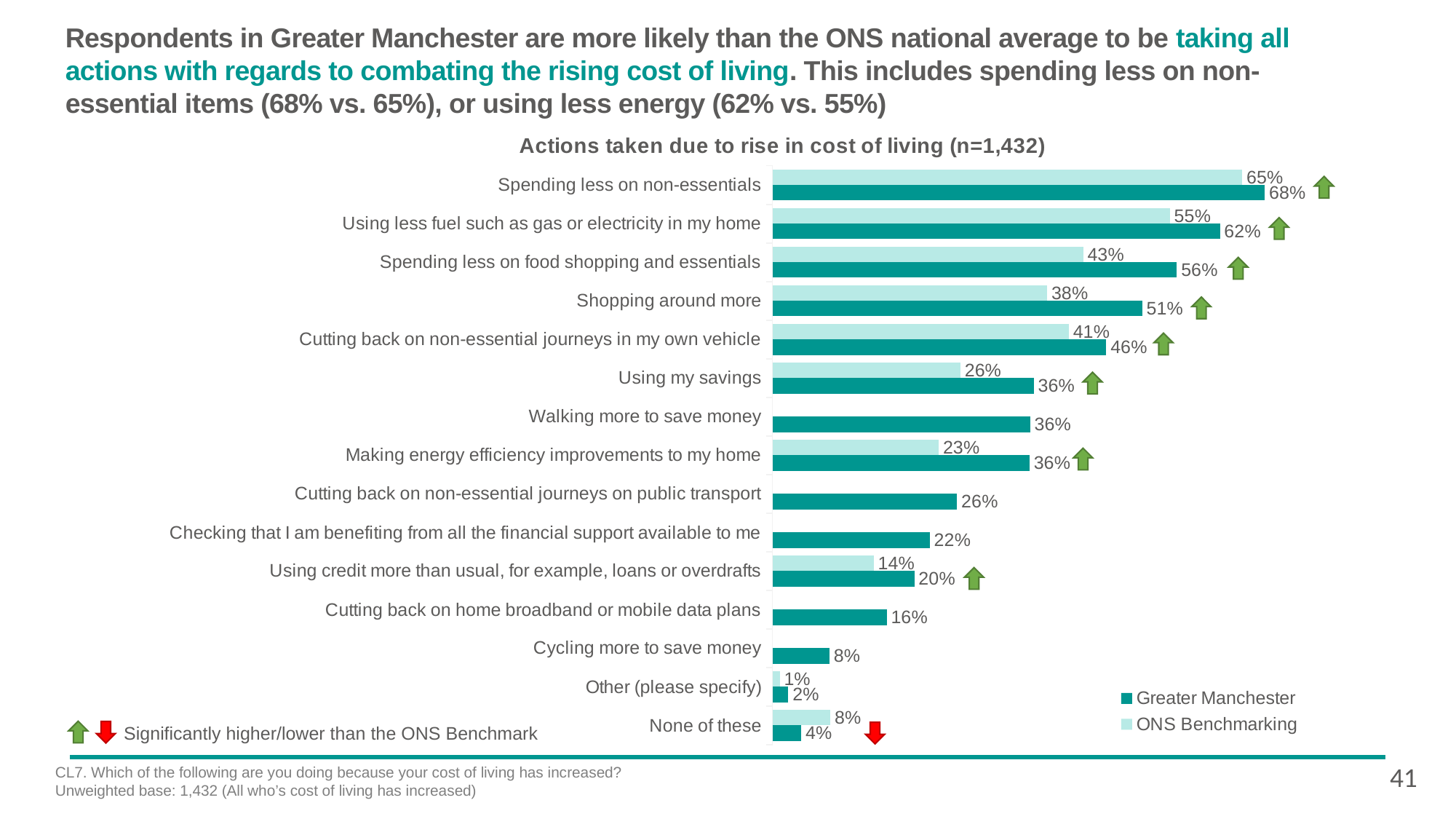
How many series does the legend list? 2 What is the Greater Manchester value for 'Shopping around more'? 51% How many action categories are shown on the chart? 15 Which category has the lowest Greater Manchester value? Other (please specify) What is the ONS Benchmarking value for 'Using my savings'? 26% For 'None of these', which is larger: the Greater Manchester value or the ONS Benchmarking value? ONS Benchmarking What is the title of the chart? Actions taken due to rise in cost of living (n=1,432) What is the Greater Manchester value for 'Cycling more to save money'? 8% Which action has the highest Greater Manchester value? Spending less on non-essentials What is the Greater Manchester value for 'Cutting back on home broadband or mobile data plans'? 16% What kind of chart is shown on the slide? Bar chart What is the difference between the Greater Manchester and ONS Benchmarking values for 'Spending less on food shopping and essentials'? 13 percentage points